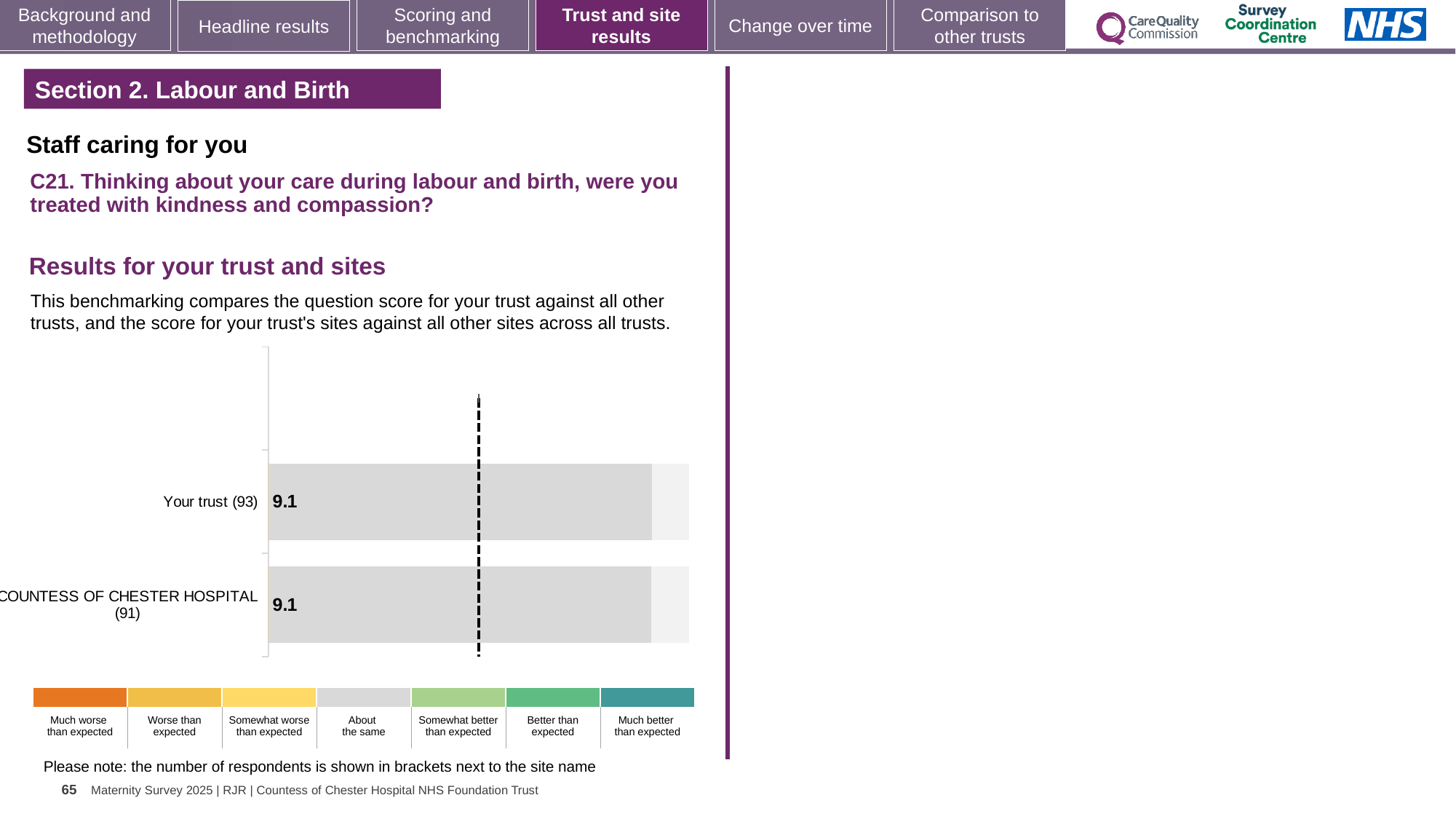
How many respondents are shown in brackets for Your trust? 93 How many categories does the colour key below the chart list? 7 Which colour-key category do the grey bars for Your trust and COUNTESS OF CHESTER HOSPITAL correspond to? About the same What is the score shown for COUNTESS OF CHESTER HOSPITAL (91)? 9.1 What is the difference between the score for Your trust (93) and the score for COUNTESS OF CHESTER HOSPITAL (91)? 0 How many bars are plotted in the chart? 2 How many respondents are shown in brackets for COUNTESS OF CHESTER HOSPITAL? 91 What kind of chart is shown on the slide? Bar chart What is the score shown for Your trust (93)? 9.1 Is the score for Your trust (93) the same as the score for COUNTESS OF CHESTER HOSPITAL (91)? Yes